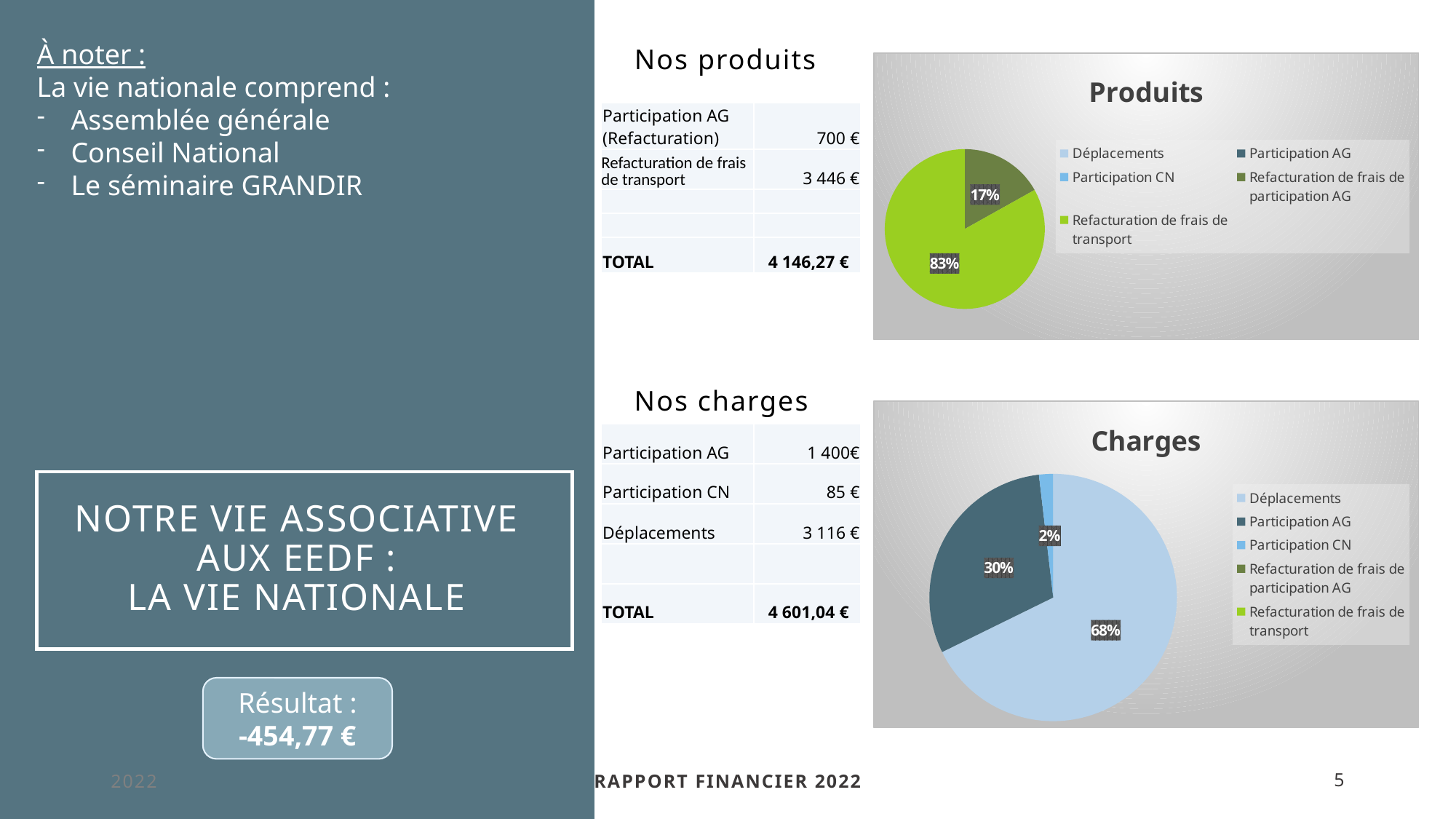
In the 'Produits' chart, what share of the pie is Refacturation de frais de transport? 83% What type of chart is the 'Produits' chart? pie chart In the 'Charges' chart, what share of the pie is Participation AG? 30% In the 'Charges' chart, which category has the smallest slice? Participation CN How many entries does the legend of the 'Charges' chart list? 5 In the 'Produits' chart, what share of the pie is Refacturation de frais de participation AG? 17% In the 'Charges' chart, what is the difference in percentage points between the Déplacements slice and the Participation AG slice? 38 What type of chart is the 'Charges' chart? pie chart In the 'Produits' chart, which is larger: the Refacturation de frais de transport slice or the Refacturation de frais de participation AG slice? Refacturation de frais de transport In the 'Charges' chart, which category has the largest slice? Déplacements